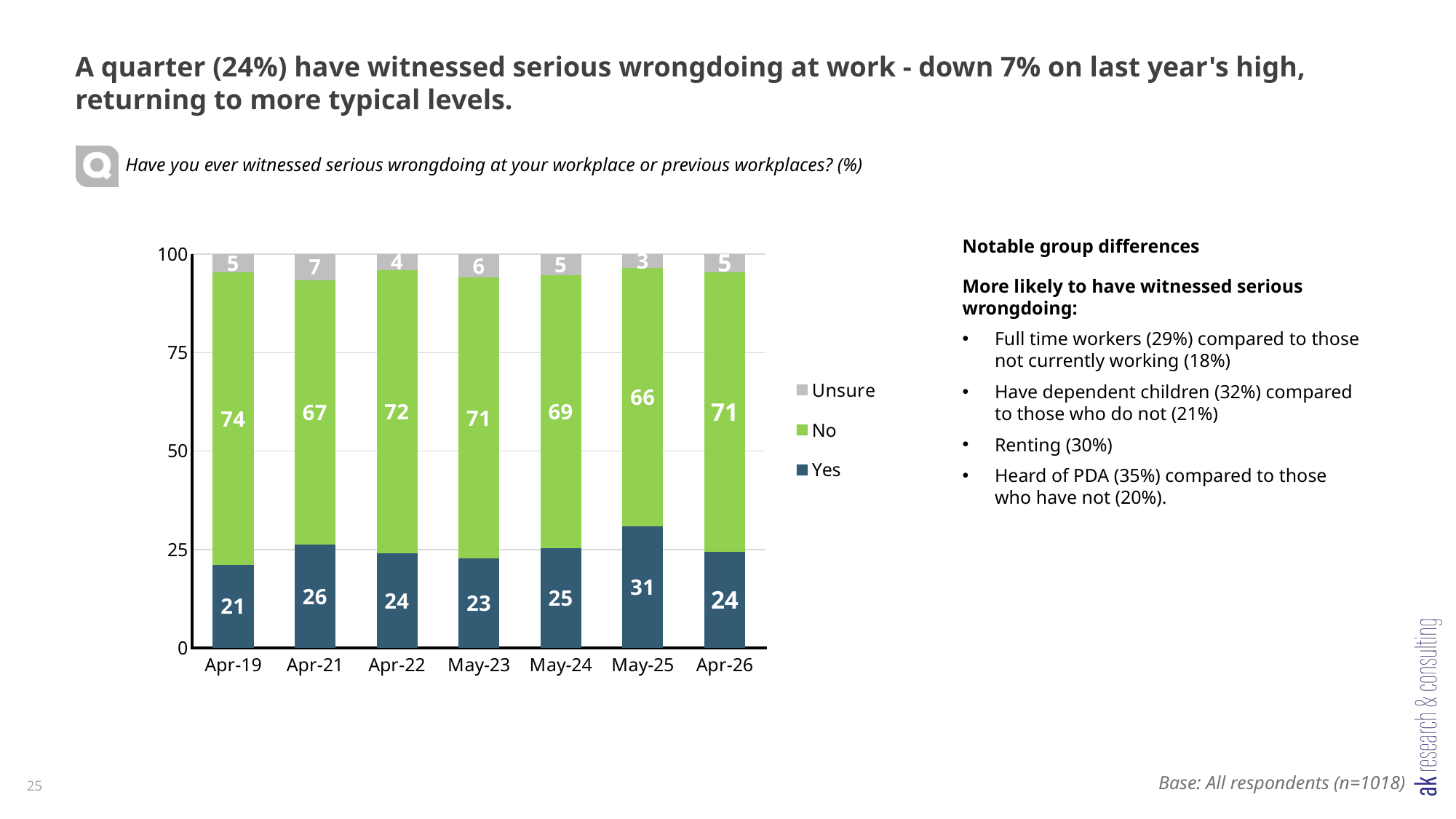
Which period has the lowest 'Yes' value? Apr-19 How many series does the legend list? 3 Which period has the highest 'Yes' value? May-25 What is the 'Unsure' value for Apr-21? 7 Which is larger: the 'No' value for Apr-22 or the 'No' value for May-24? Apr-22 What is the 'No' value for Apr-19? 74 What is the 'Yes' value for May-25? 31 What is the total of the stacked bar for May-23? 100 What kind of chart is shown on the slide? Stacked bar chart What is the difference between the 'Yes' value for May-25 and the 'Yes' value for Apr-26? 7 How many time periods are shown on the x axis? 7 Which period has the lowest 'Unsure' value? May-25